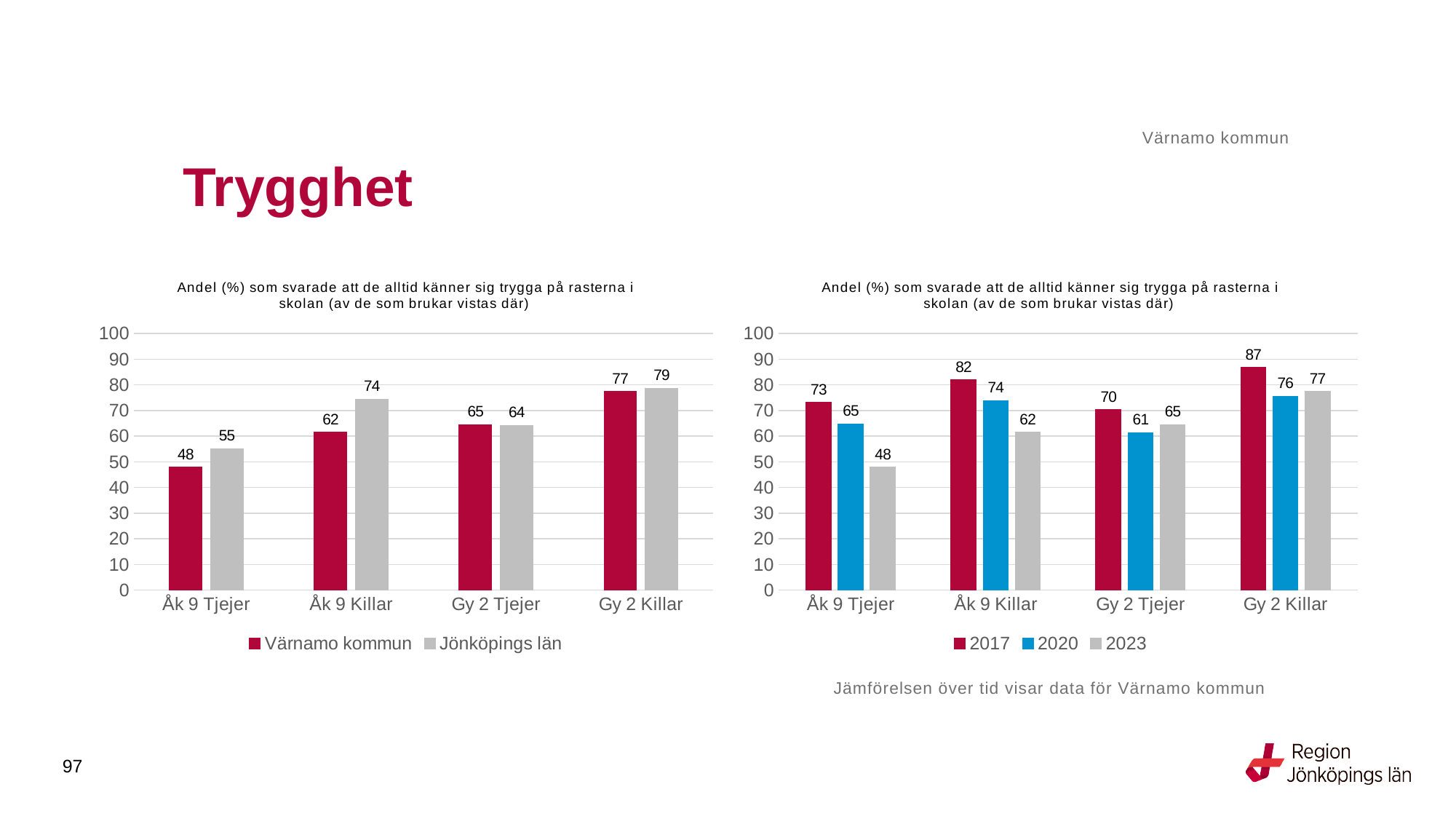
In the right chart, what is the value for 2020 for Gy 2 Tjejer? 61 In the right chart, what is the difference between the 2017 and 2023 values for Åk 9 Tjejer? 25 In the right chart, how many categories are shown on the x axis? 4 In the right chart, what is the value for 2017 for Gy 2 Killar? 87 In the left chart, what is the difference between Jönköpings län and Värnamo kommun for Åk 9 Killar? 12 In the right chart, which is larger for Åk 9 Killar: 2017 or 2023? 2017 In the left chart, which category has the lowest value for Jönköpings län? Åk 9 Tjejer In the left chart, what is the value for Jönköpings län for Gy 2 Killar? 79 What kind of chart is the right chart? Bar chart In the left chart, which category has the highest value for Värnamo kommun? Gy 2 Killar In the left chart, what is the value for Värnamo kommun for Åk 9 Tjejer? 48 In the left chart, how many series does the legend list? 2